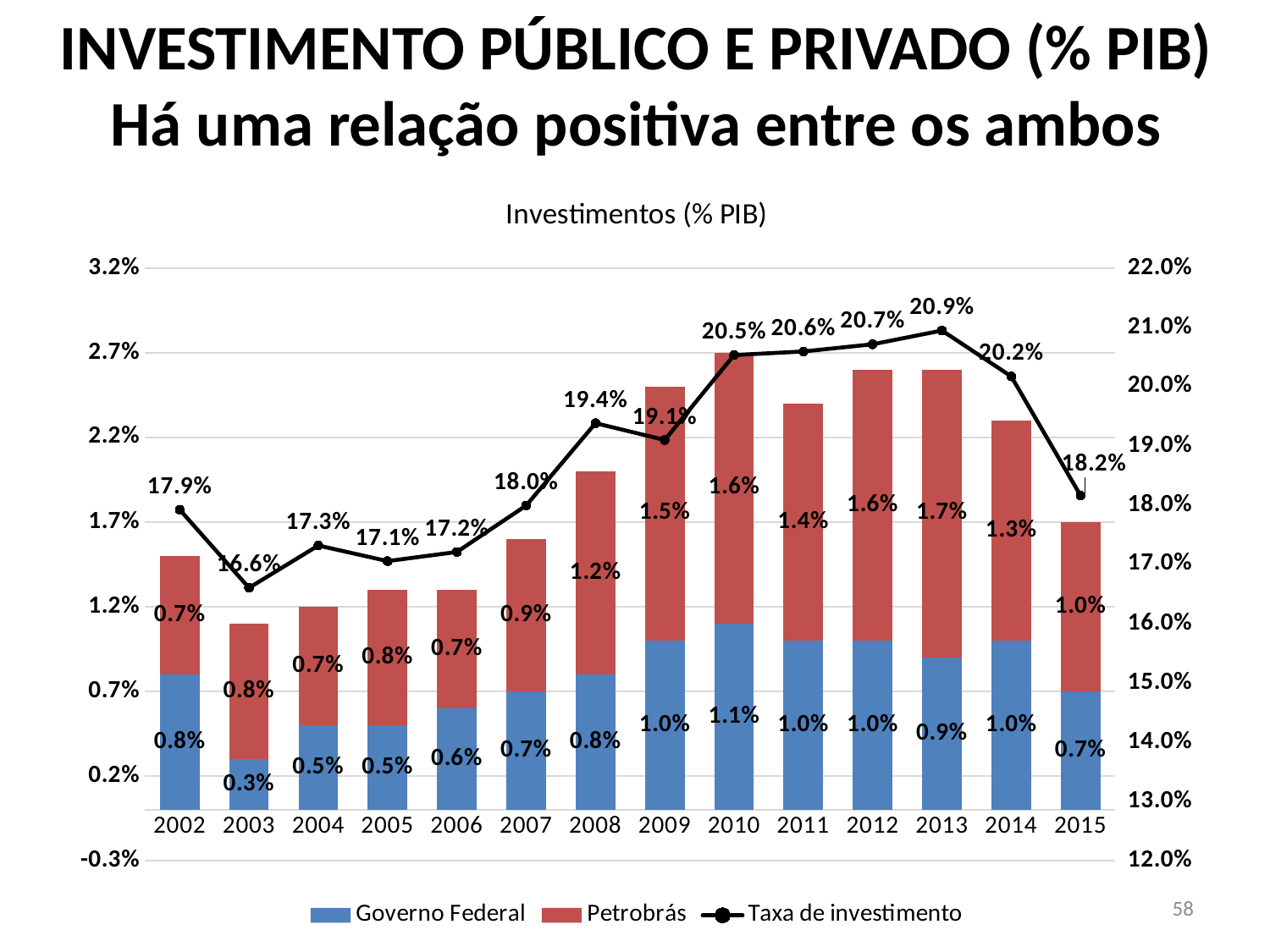
How many series does the legend list? 3 What is the difference between the Taxa de investimento in 2013 and in 2015? 2.7% How many years are shown on the x axis? 14 In which year is the Taxa de investimento lowest? 2003 Which series is plotted as a line with markers? Taxa de investimento Which is larger, the Petrobrás value for 2009 or for 2014? 2009 What is the Petrobrás value for 2013? 1.7% In which year is the Governo Federal value highest? 2010 What is the Governo Federal value for 2003? 0.3% In which year is the Taxa de investimento highest? 2013 What is the Taxa de investimento value for 2008? 19.4% What is the total of the stacked bar for 2010 (Governo Federal plus Petrobrás)? 2.7%